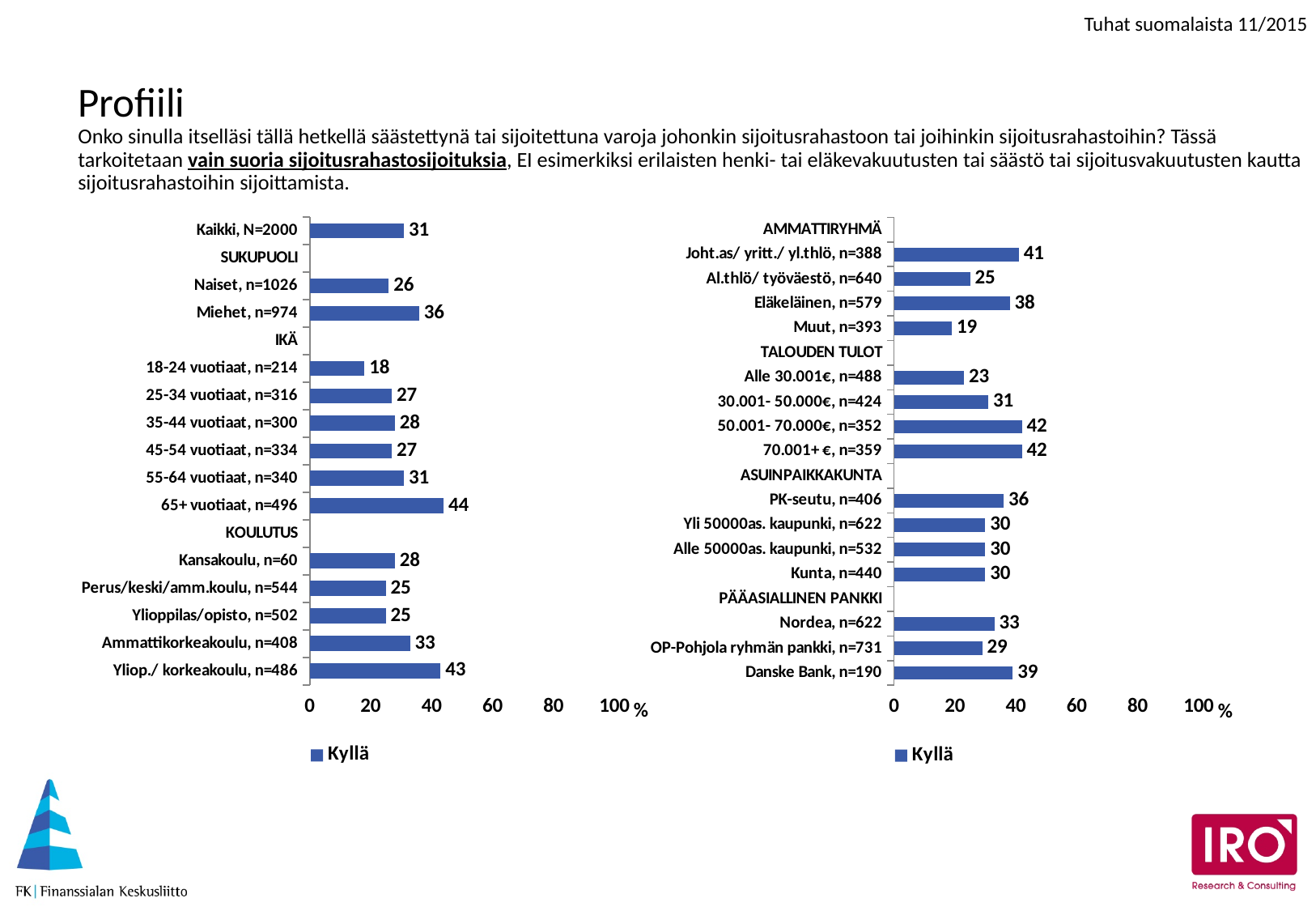
In the left chart, what is the value for 65+ vuotiaat, n=496? 44 In the right chart, what is the difference between Joht.as/ yritt./ yl.thlö, n=388 and Al.thlö/ työväestö, n=640? 16 In the right chart, how many bars are plotted? 16 In the right chart, what is the value for Muut, n=393? 19 In the left chart, what is the value for Kaikki, N=2000? 31 How many series does the legend of the right chart list? 1 What kind of chart is the left chart? Bar chart In the left chart, what is the difference between Miehet, n=974 and Naiset, n=1026? 10 In the right chart, which category has the lowest value? Muut, n=393 In the left chart, which category has the lowest value? 18-24 vuotiaat, n=214 In the left chart, which is larger: Ammattikorkeakoulu, n=408 or Kansakoulu, n=60? Ammattikorkeakoulu, n=408 In the right chart, what is the value for Danske Bank, n=190? 39